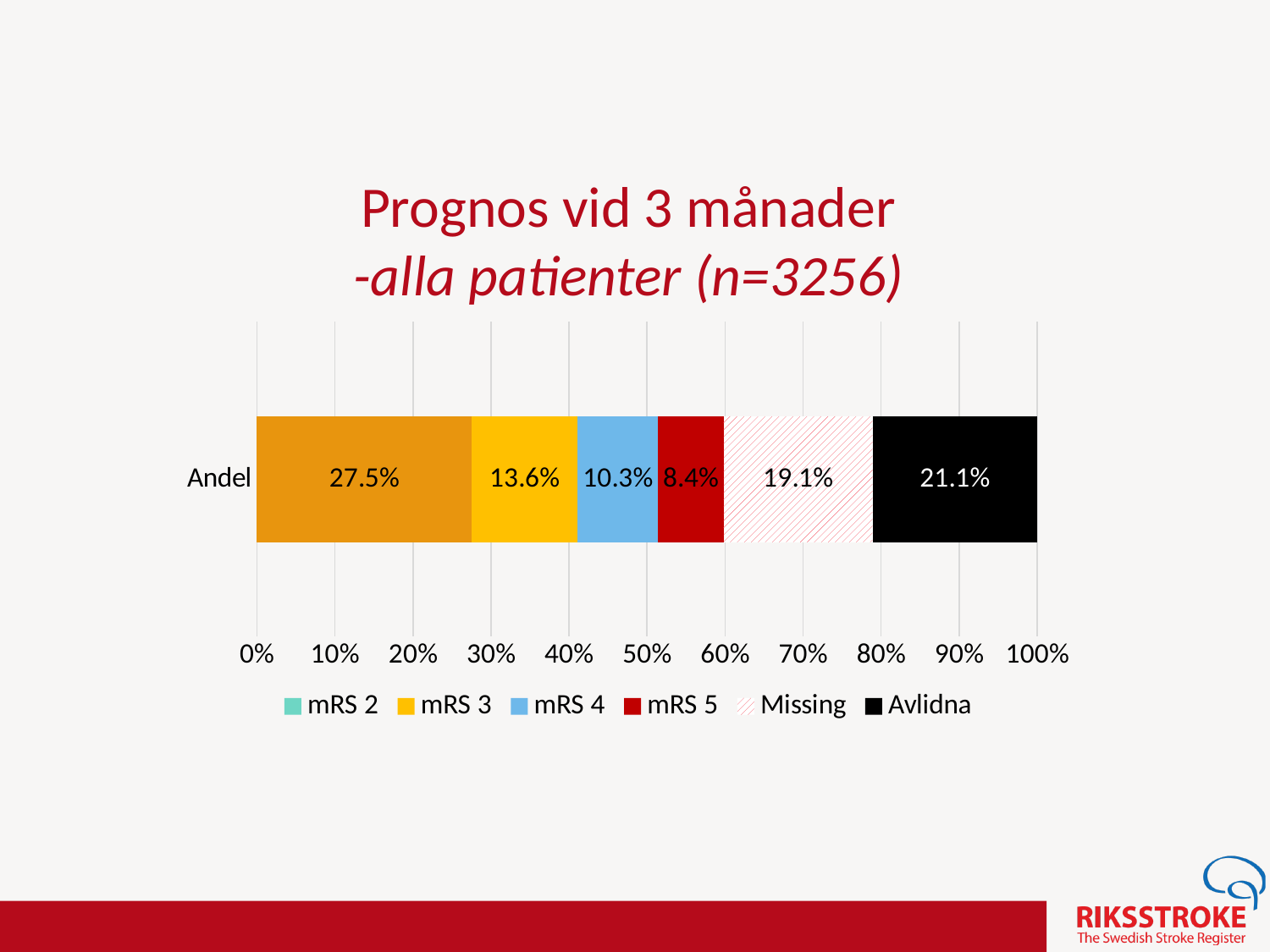
What type of chart is shown on the slide? Stacked bar chart Which segment of the bar has the smallest value? mRS 5 Which is larger, the Avlidna segment or the Missing segment? Avlidna What is the value of the mRS 3 segment in the bar? 13.6% What is the value of the mRS 4 segment in the bar? 10.3% What is the value of the Missing segment in the bar? 19.1% How many series does the legend list? 6 What is the difference between the Avlidna segment and the Missing segment? 2.0% What is the difference between the mRS 3 segment and the mRS 4 segment? 3.3% What is the value of the mRS 5 segment in the bar? 8.4% What is the value of the first (orange) segment at the left of the bar? 27.5% What is the value of the Avlidna segment in the bar? 21.1%